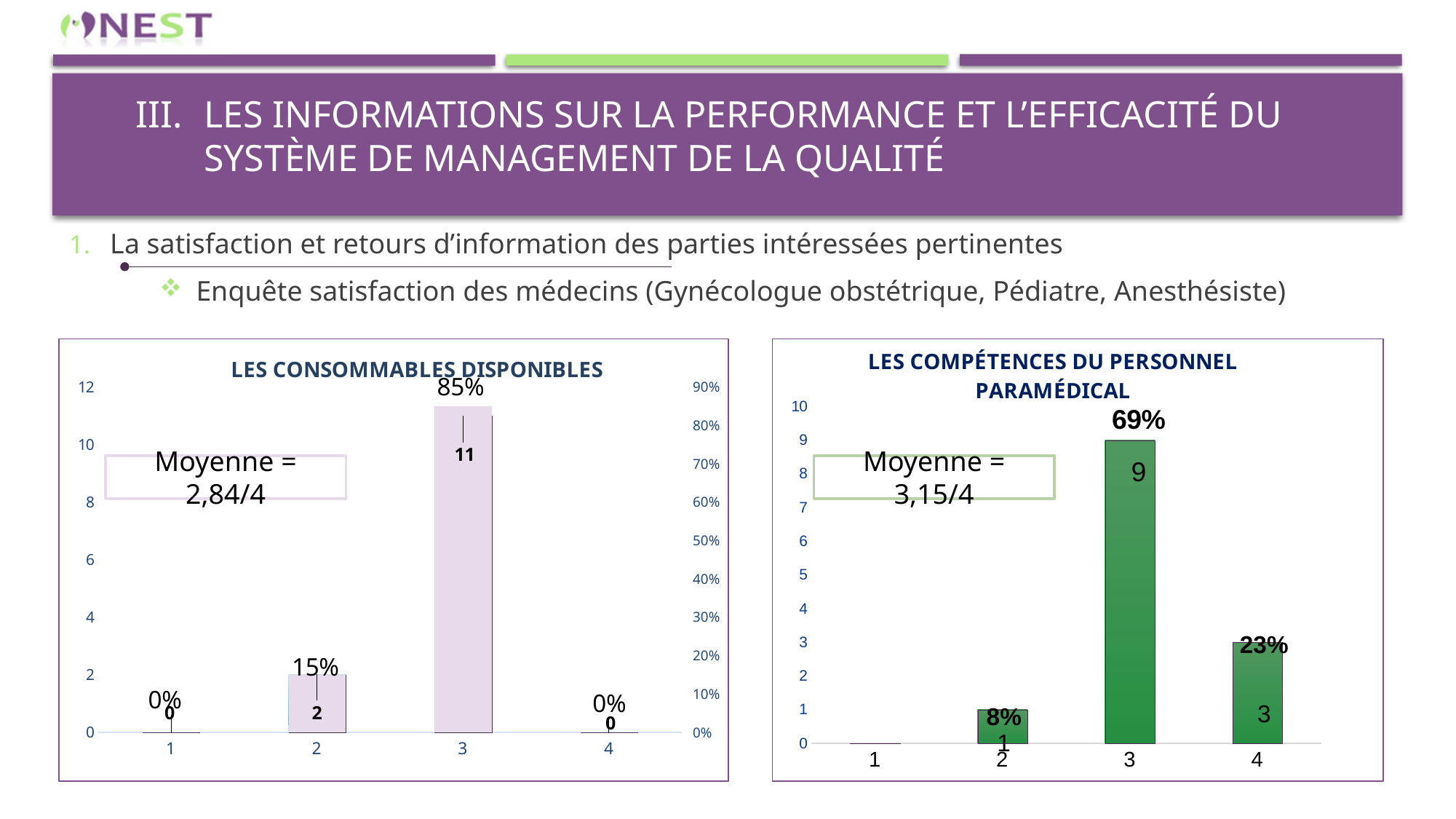
In the chart titled "LES COMPÉTENCES DU PERSONNEL PARAMÉDICAL", what average (Moyenne) is displayed in the text box? 3,15/4 What type of chart is the chart titled "LES COMPÉTENCES DU PERSONNEL PARAMÉDICAL"? bar chart In the chart titled "LES CONSOMMABLES DISPONIBLES", what average (Moyenne) is displayed in the text box? 2,84/4 In the chart titled "LES COMPÉTENCES DU PERSONNEL PARAMÉDICAL", which is larger, the value for category 2 or category 4? 4 In the chart titled "LES CONSOMMABLES DISPONIBLES", what percentage is shown for category 2? 15% In the chart titled "LES COMPÉTENCES DU PERSONNEL PARAMÉDICAL", what percentage is shown for category 4? 23% In the chart titled "LES CONSOMMABLES DISPONIBLES", how many categories are shown on the x axis? 4 In the chart titled "LES COMPÉTENCES DU PERSONNEL PARAMÉDICAL", what is the difference between the counts for category 3 and category 4? 6 In the chart titled "LES COMPÉTENCES DU PERSONNEL PARAMÉDICAL", what is the count value for category 3? 9 In the chart titled "LES CONSOMMABLES DISPONIBLES", which category has the highest value? 3 In the chart titled "LES CONSOMMABLES DISPONIBLES", what is the difference between the counts for category 3 and category 2? 9 In the chart titled "LES CONSOMMABLES DISPONIBLES", what is the count value for category 3? 11